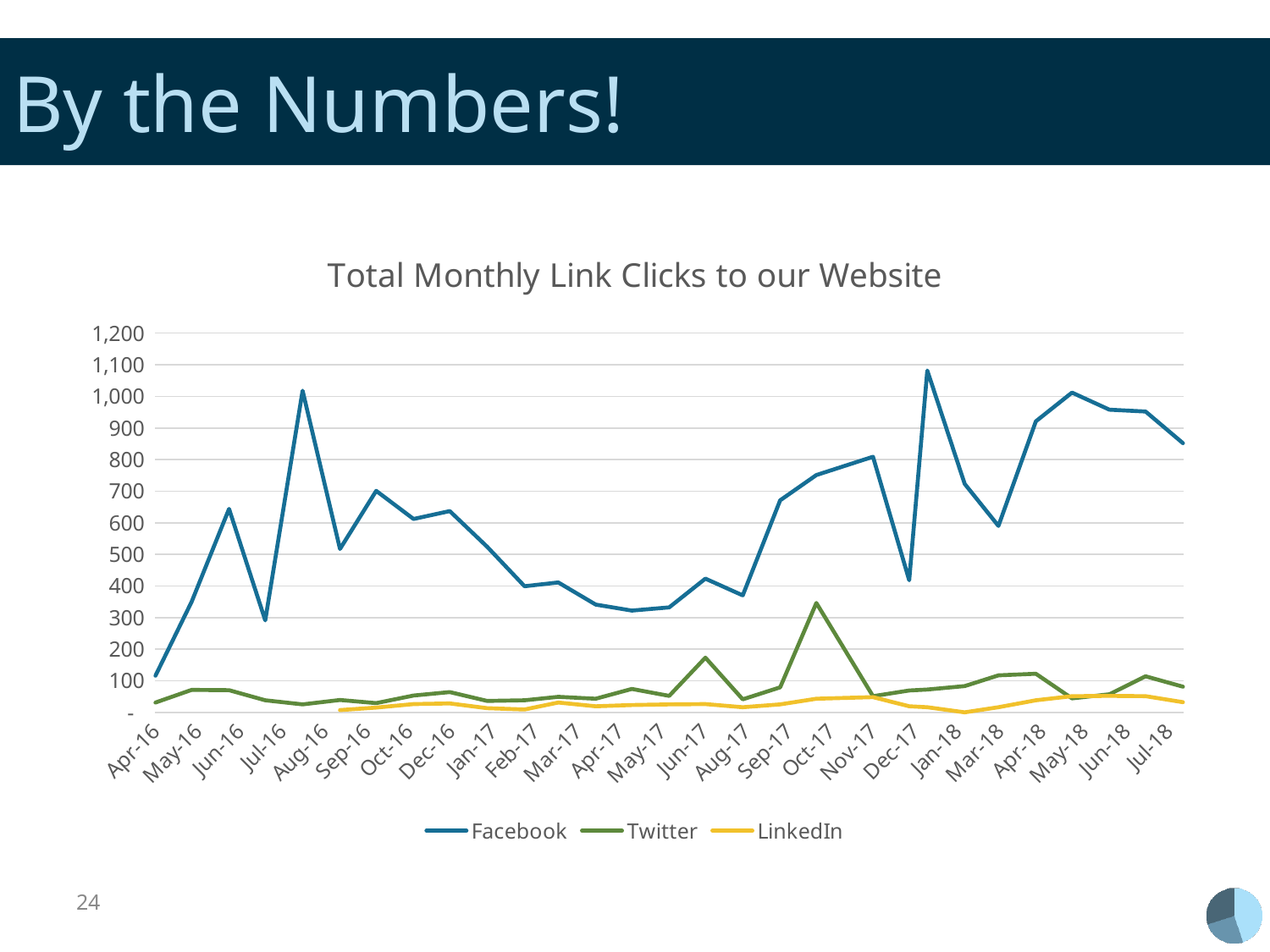
In which month does the Twitter series reach its highest value? Oct-17 Is the value for Facebook in Apr-16 greater or less than 200? less Which series has the highest values throughout the chart? Facebook Does the Facebook series rise or fall from Apr-16 to Jun-16? Rise What kind of chart is shown on the slide? Line chart Is the value for Facebook in Jan-18 greater or less than 1,000? greater Is the value for Facebook in Dec-17 greater or less than 500? less What is the title of the chart? Total Monthly Link Clicks to our Website In Oct-17, which is larger, the Facebook value or the Twitter value? Facebook How many series does the legend list? 3 In which month does the Facebook series reach its highest value? Jan-18